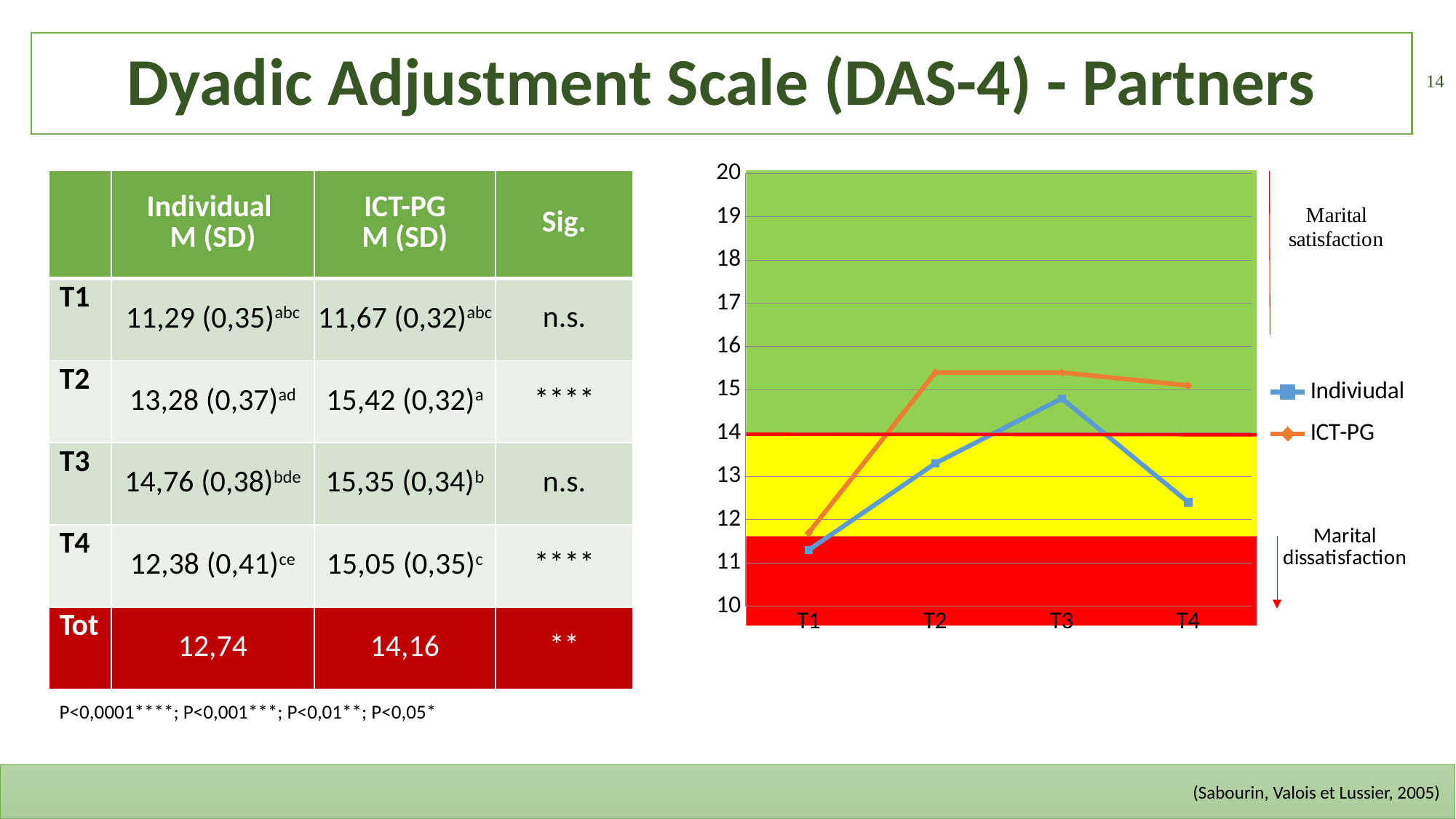
At which time point is the ICT-PG series lowest? T1 How many series does the chart legend list? 2 Does the Indiviudal series rise or fall from T3 to T4? fall Is the value for the Indiviudal series at T4 greater or less than 13? less What kind of chart is shown on the slide? line chart Is the value for the ICT-PG series at T2 greater or less than 15? greater At T2, which series has the higher value, Indiviudal or ICT-PG? ICT-PG How many time points are plotted along the x axis of the chart? 4 At which time point is the Indiviudal series highest? T3 Is the value for the ICT-PG series at T1 greater or less than 12? less Which series is drawn in orange on the chart? ICT-PG